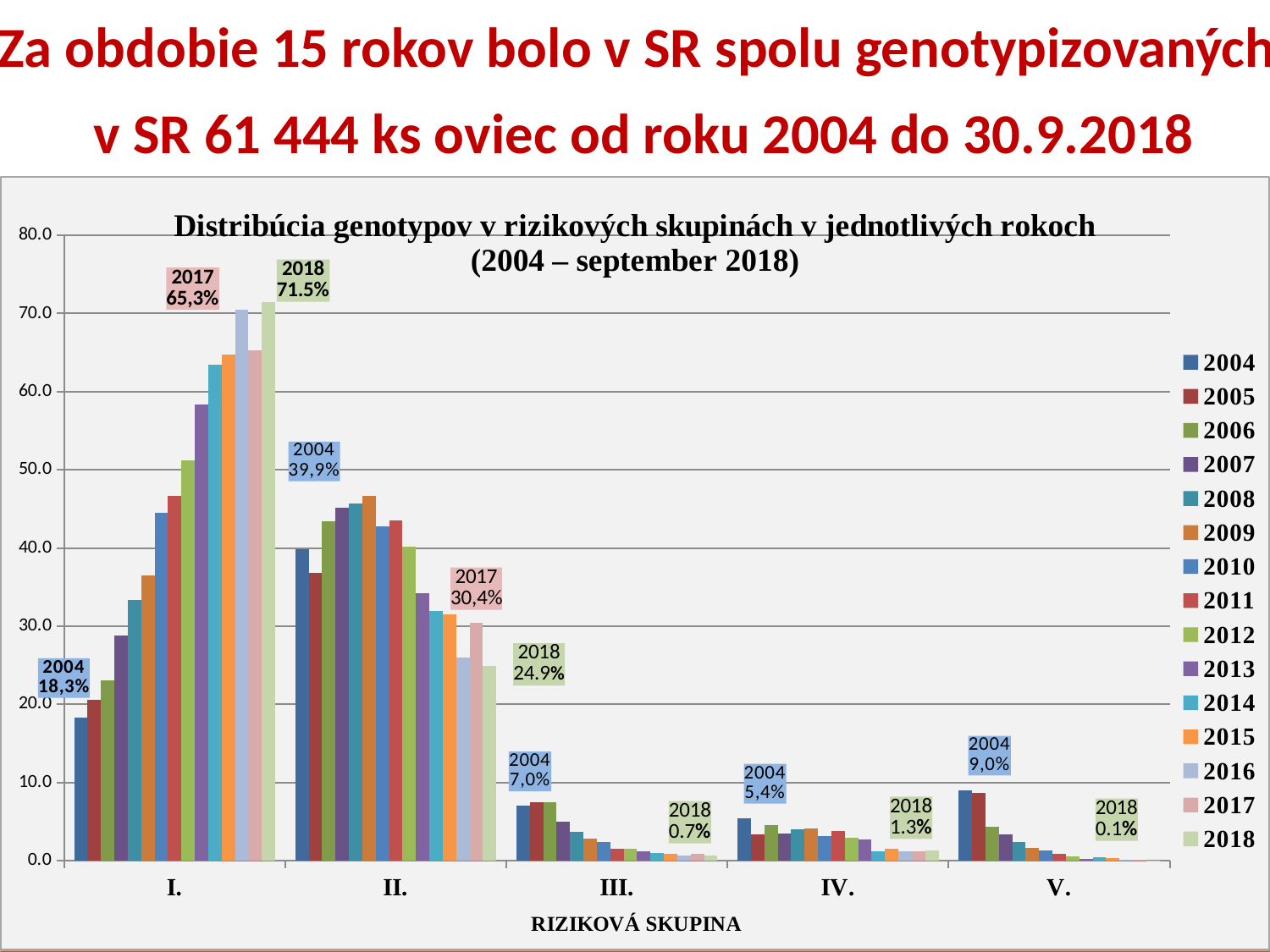
Which year has the highest bar in risk group I.? 2018 What is the labelled value for 2004 in risk group IV.? 5,4% What is the title of the chart? Distribúcia genotypov v rizikových skupinách v jednotlivých rokoch (2004 – september 2018) What is the labelled value for 2018 in risk group V.? 0.1% What is the labelled value for 2004 in risk group II.? 39,9% Which is larger in risk group III.: the 2004 value or the 2018 value? 2004 How many series does the legend list? 15 How many risk group categories are shown on the x axis? 5 What is the labelled value for 2018 in risk group I.? 71.5% What is the labelled value for 2017 in risk group II.? 30,4% What kind of chart is shown on the slide? bar chart Is the value for 2010 in risk group I. greater or less than 40.0? greater